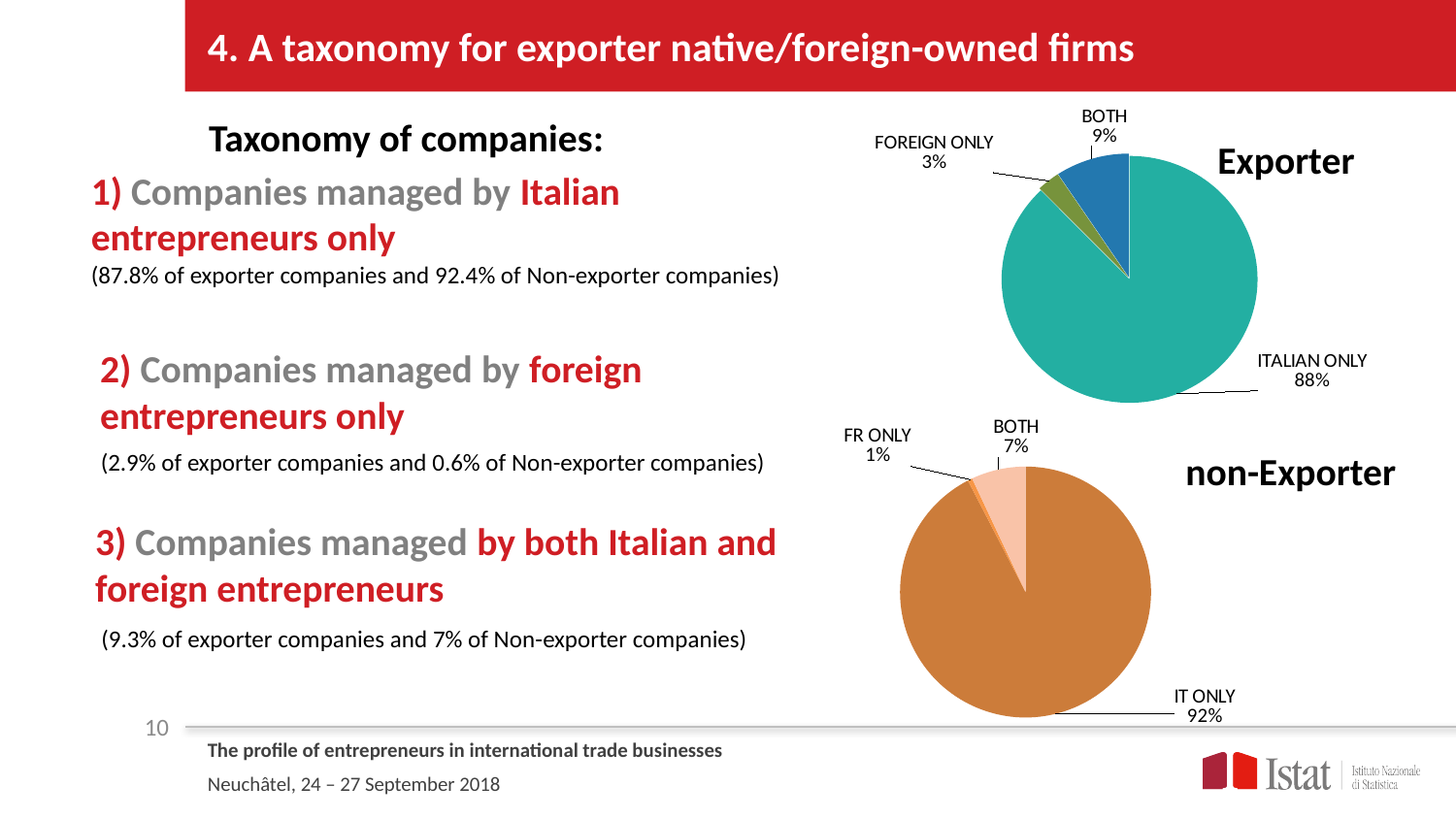
How many slices does the non-Exporter pie chart have? 3 In the non-Exporter pie chart, which category has the smallest slice? FR ONLY Which is larger: the BOTH slice in the Exporter chart or the BOTH slice in the non-Exporter chart? The BOTH slice in the Exporter chart In the Exporter pie chart, what share is labelled for ITALIAN ONLY? 88% In the non-Exporter pie chart, what share is labelled for FR ONLY? 1% In the Exporter pie chart, what share is labelled for BOTH? 9% In the non-Exporter pie chart, what share is labelled for IT ONLY? 92% What type of chart is used for the Exporter data? Pie chart In the non-Exporter pie chart, what share is labelled for BOTH? 7% In the Exporter pie chart, which category has the largest slice? ITALIAN ONLY In the Exporter pie chart, what share is labelled for FOREIGN ONLY? 3% In the Exporter pie chart, what is the difference in percentage points between the BOTH slice and the FOREIGN ONLY slice? 6 percentage points